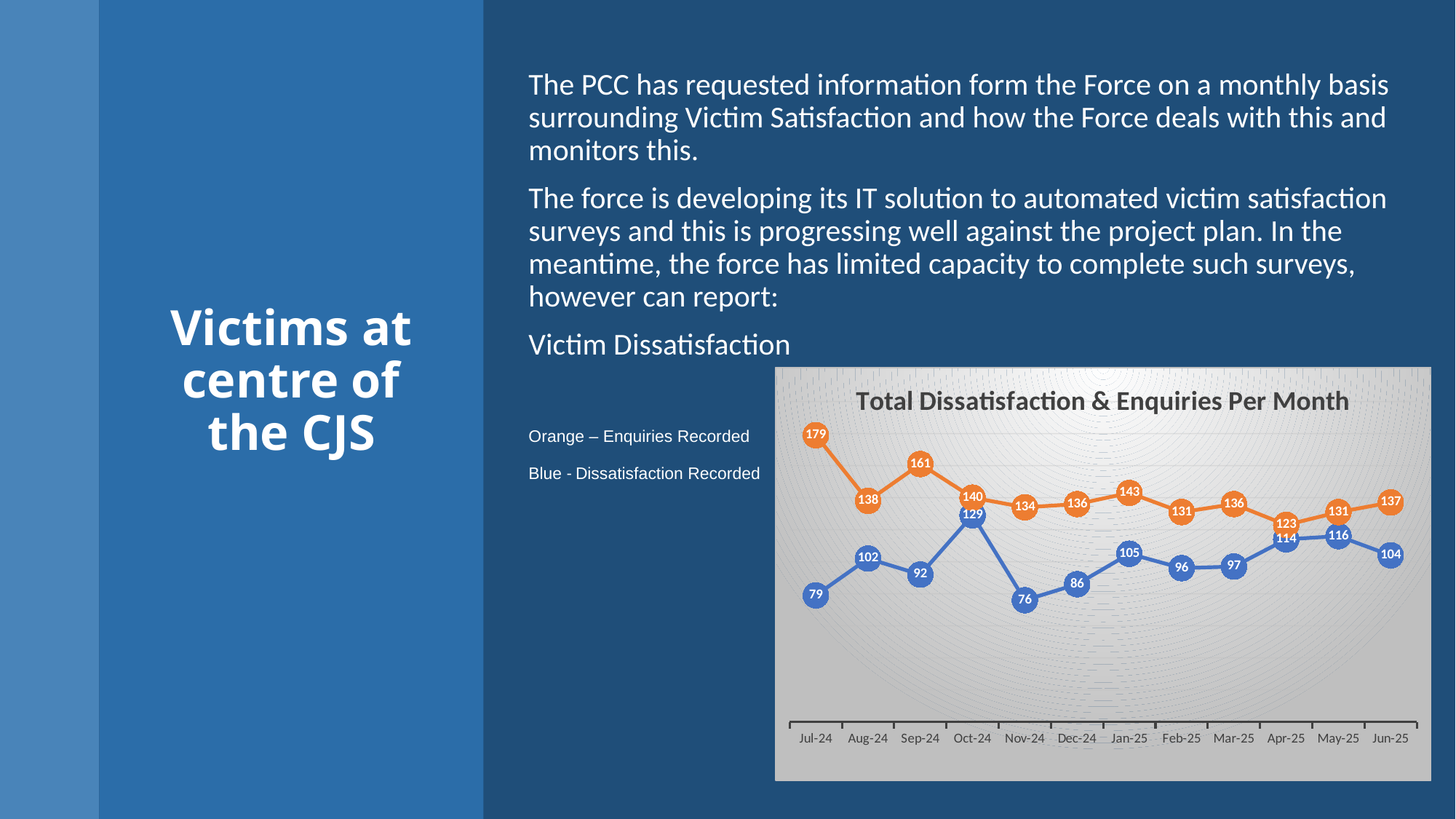
What is the value of the blue (Dissatisfaction Recorded) line for Oct-24? 129 In which month is the orange (Enquiries Recorded) line at its highest? Jul-24 In which month is the orange (Enquiries Recorded) line at its lowest? Apr-25 Which is larger in Sep-24: the orange (Enquiries Recorded) value or the blue (Dissatisfaction Recorded) value? Orange (Enquiries Recorded) What is the title of the chart? Total Dissatisfaction & Enquiries Per Month What is the value of the blue (Dissatisfaction Recorded) line for Nov-24? 76 How many months are plotted along the x axis of the chart? 12 What is the difference between the orange and blue values in Jul-24? 100 What is the value of the orange (Enquiries Recorded) line for Jul-24? 179 Does the blue (Dissatisfaction Recorded) line rise or fall from Oct-24 to Nov-24? Fall What type of chart is shown on the slide? Line chart In which month is the blue (Dissatisfaction Recorded) line at its lowest? Nov-24